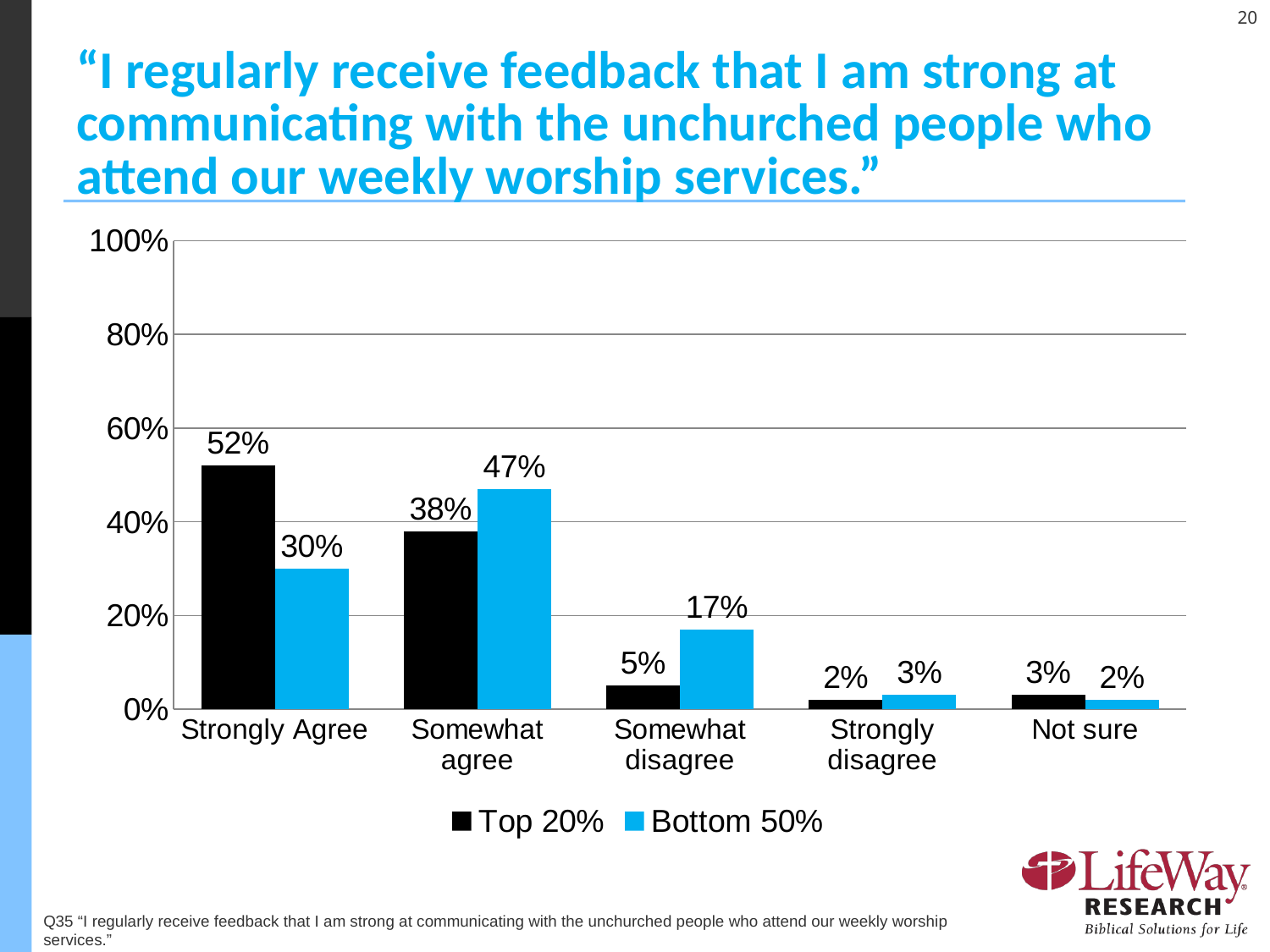
What is the value for Bottom 50% in the Somewhat agree category? 47% How many series does the legend list? 2 Which colour represents the Bottom 50% series? Blue What is the difference between Top 20% and Bottom 50% in the Strongly Agree category? 22% What is the value for Top 20% in the Not sure category? 3% Which category has the highest value for the Top 20% series? Strongly Agree What kind of chart is shown on the slide? Bar chart What is the value for Bottom 50% in the Somewhat disagree category? 17% What is the value for Top 20% in the Strongly Agree category? 52% How many categories are shown on the x axis? 5 Which category has the lowest value for the Bottom 50% series? Not sure Which is larger in the Somewhat agree category, Top 20% or Bottom 50%? Bottom 50%